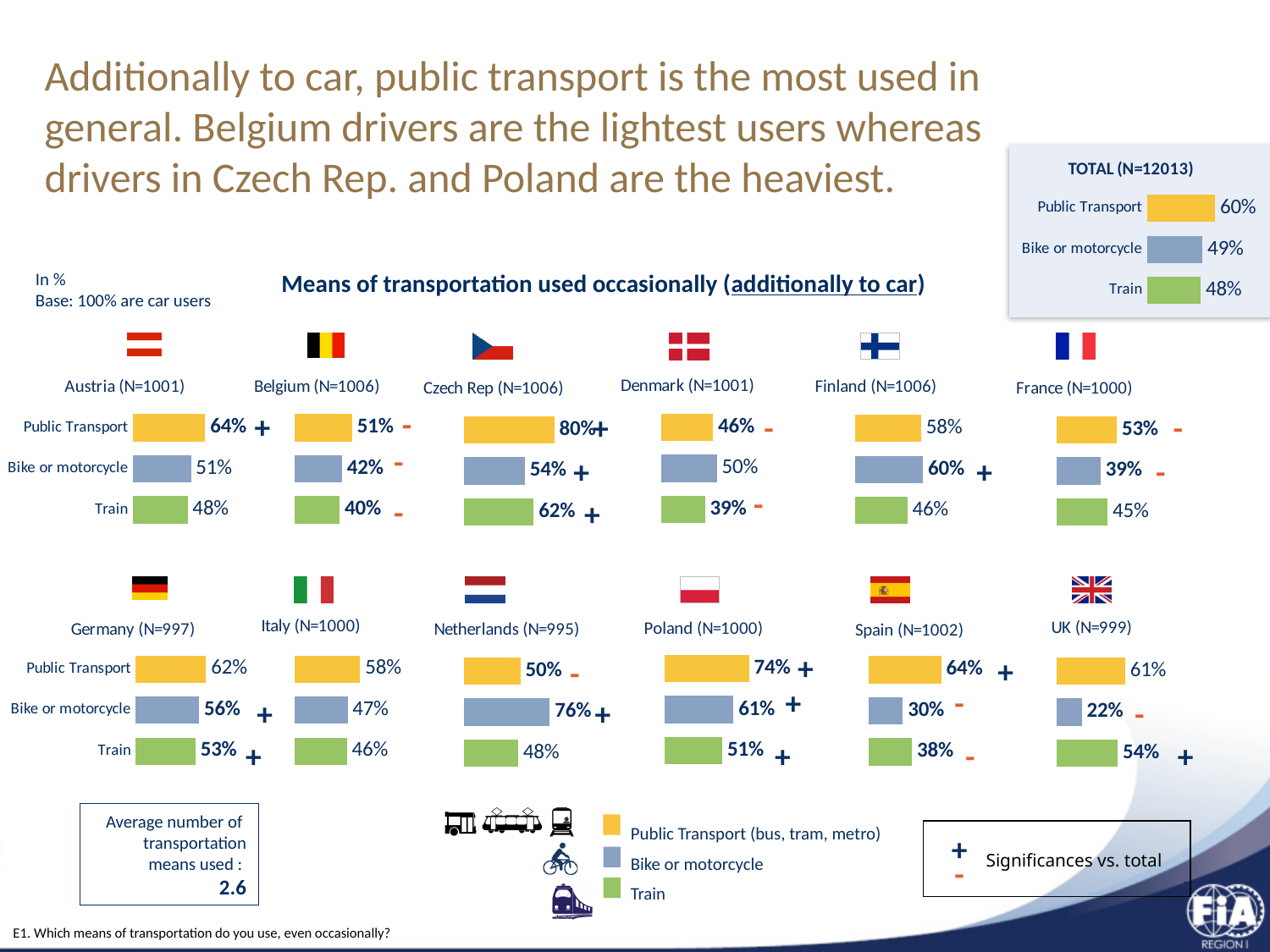
Across the country charts, which country has the lowest Train value? Spain In the Finland chart, which is larger: Public Transport or Bike or motorcycle? Bike or motorcycle What colour are the Train bars in the charts? Green Across the country charts, which country has the lowest Bike or motorcycle value? UK In the UK chart, what is the value for Bike or motorcycle? 22% In the Netherlands chart, what is the difference between the Bike or motorcycle value and the Public Transport value? 26 percentage points How many means of transportation does the legend at the bottom of the slide list? 3 In the TOTAL (N=12013) chart, what is the value for Train? 48% How many country charts are shown on the slide (excluding the TOTAL chart)? 12 In the Czech Rep chart, what percentage of car users occasionally use public transport? 80% Across the country charts, which country has the highest Public Transport value? Czech Rep What type of chart is used to show the means of transportation for each country? Bar chart